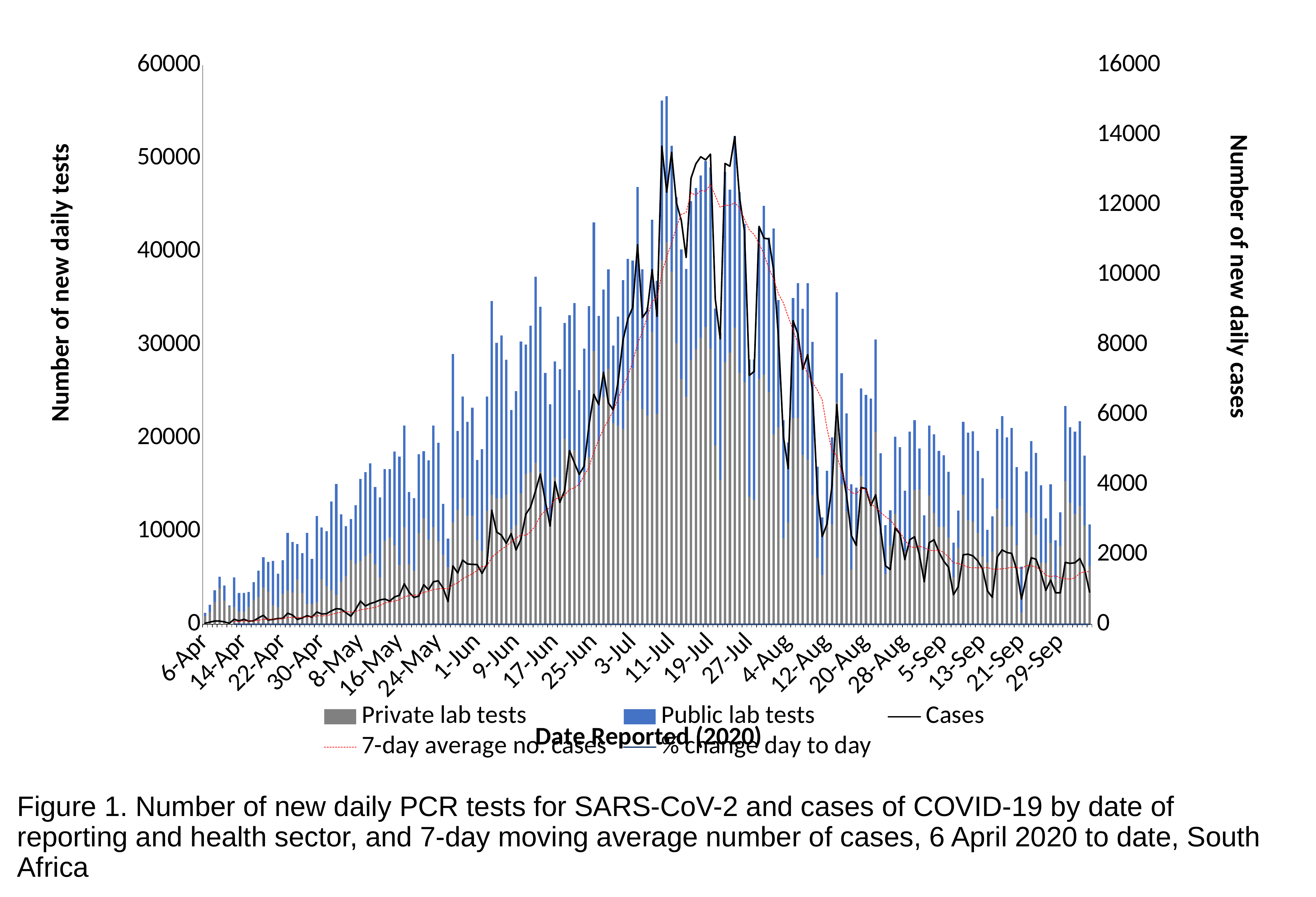
Is the number of cases on 6-Apr greater or less than 2000? less What kind of chart is shown on the slide? A combined bar and line chart Is the total number of daily tests on 6-Apr greater or less than 10000? less How many date labels are shown on the x axis? 23 What is the title of the right-hand vertical axis? Number of new daily cases How many entries does the chart legend list? 5 What colour are the bars for Private lab tests? Grey Does the Cases line rise or fall between 6-Apr and 11-Jul? rise Is the peak of the Cases line greater or less than 12000 on the right axis? greater Near which x-axis date label do the tallest test bars occur? 11-Jul Does the 7-day average no. cases line rise or fall between 27-Jul and 29-Sep? fall